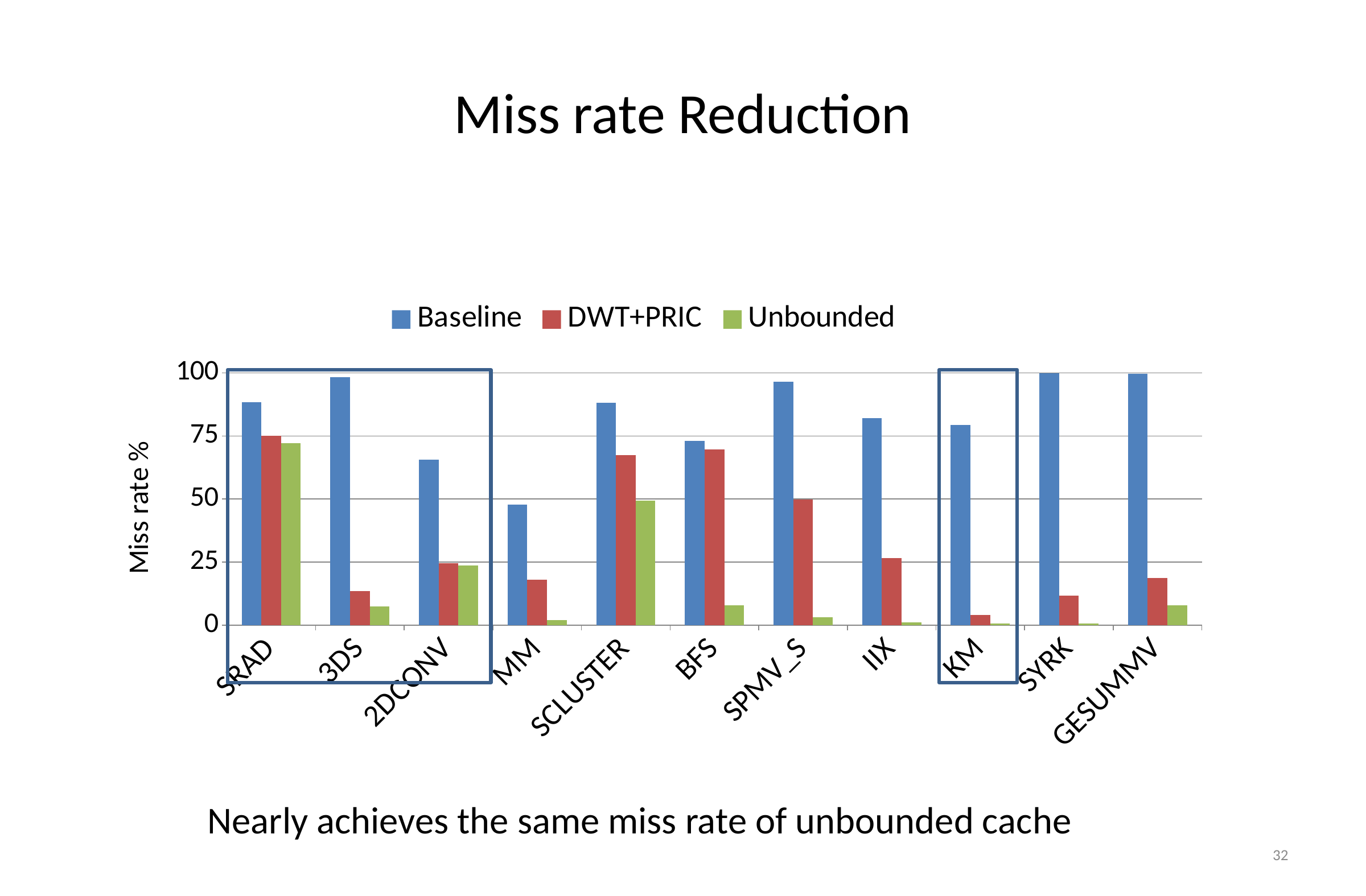
How many series does the legend list? 3 Which category has the highest Unbounded miss rate? SRAD Is the DWT+PRIC miss rate for SRAD greater or less than 50? greater Is the Baseline miss rate for IIX greater or less than 75? greater How many benchmark categories are shown on the x axis? 11 What is the label of the y axis? Miss rate % Is the Baseline miss rate for MM greater or less than 50? less For SCLUSTER, which is larger: the DWT+PRIC miss rate or the Unbounded miss rate? DWT+PRIC Which category has the lowest Baseline miss rate? MM What kind of chart is shown on the slide? bar chart Which category has the lowest DWT+PRIC miss rate? KM